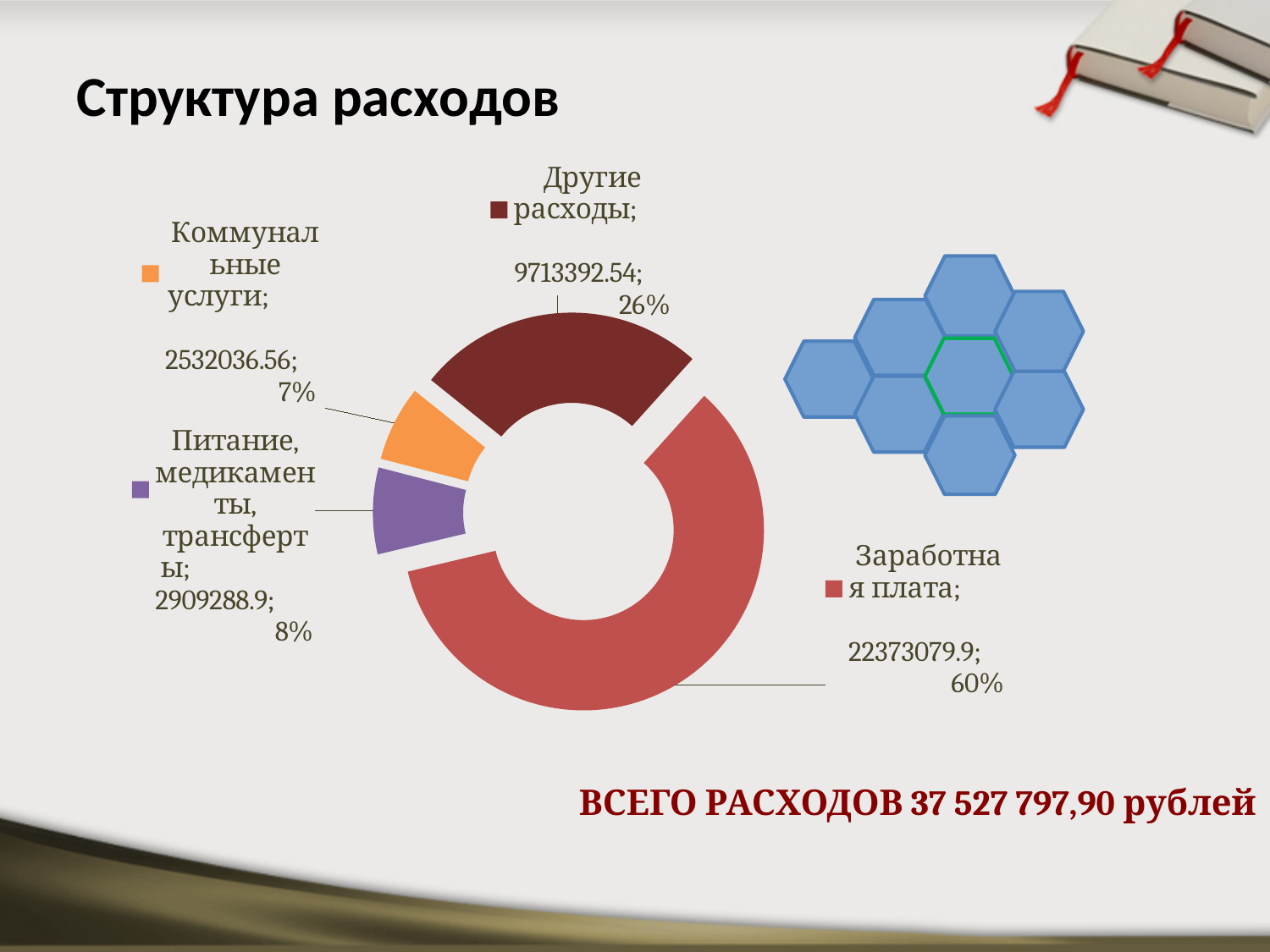
What is the value shown for Другие расходы? 9713392.54 Which is larger, Другие расходы or Питание, медикаменты, трансферты? Другие расходы What share of the chart does Коммунальные услуги take? 7% What is the difference in percentage points between the shares of Заработная плата and Другие расходы? 34% What is the value shown for Заработная плата? 22373079.9 What is the value shown for Питание, медикаменты, трансферты? 2909288.9 What is the value shown for Коммунальные услуги? 2532036.56 What kind of chart is shown on the slide? doughnut chart How many categories does the chart show? 4 Which category has the largest share of the chart? Заработная плата Which category has the smallest share of the chart? Коммунальные услуги What share of the chart does Заработная плата take? 60%